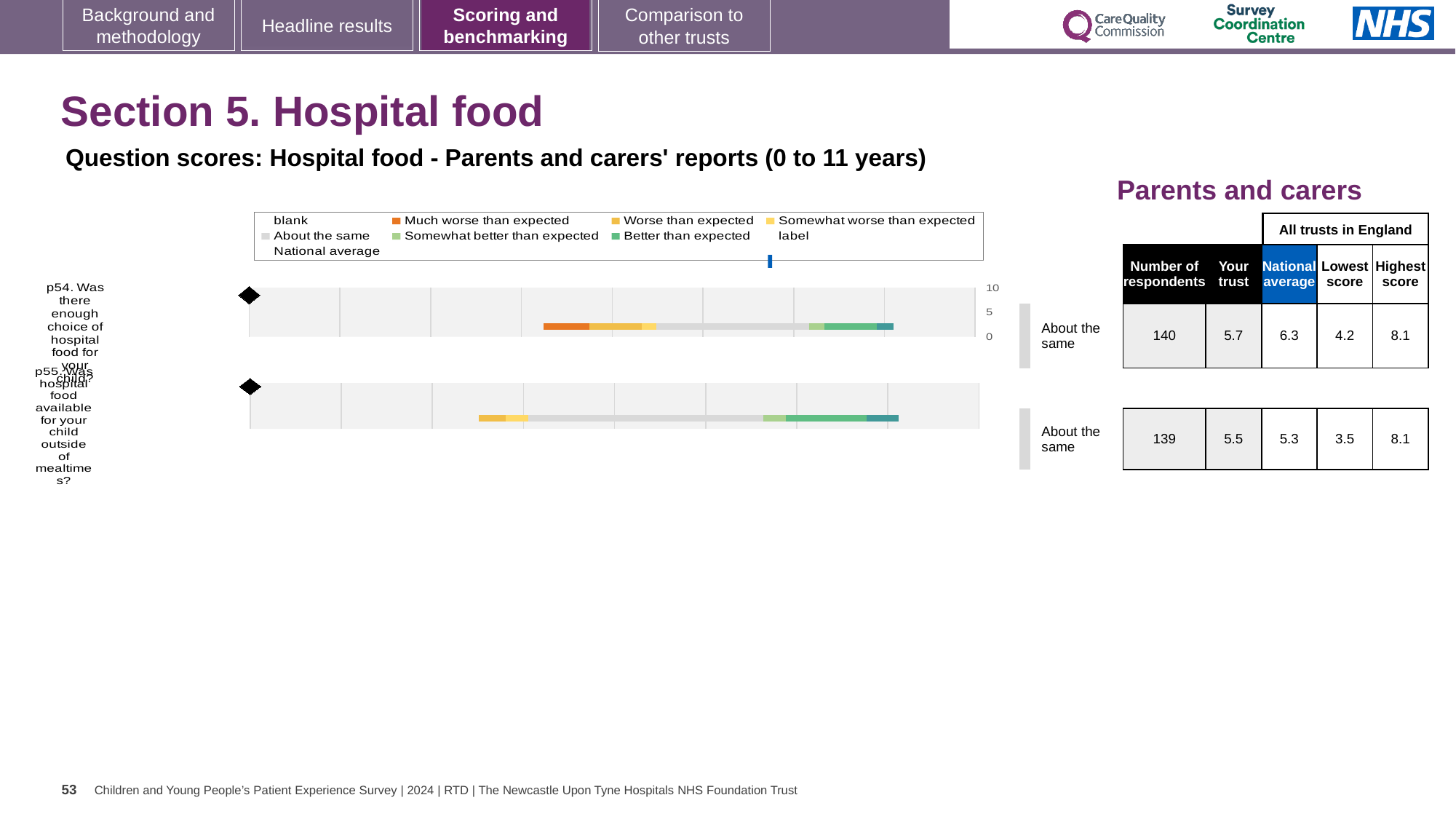
How many respondents answered p54? 140 By how much does the national average exceed the 'Your trust' score for p54? 0.6 What is the lowest score among all trusts in England for p54? 4.2 What benchmark category is shown for p55? About the same Is the 'Your trust' score for p54 greater or less than 5? greater What is the national average score for p55 (food available outside of mealtimes)? 5.3 What is the difference between the highest score and the lowest score for p55? 4.6 How many questions are plotted in the hospital food chart? 2 For p54, which is larger: the 'Your trust' score or the national average? National average What kind of chart is used to show the question scores for hospital food? bar chart Which question has the higher 'Your trust' score, p54 or p55? p54 What is the 'Your trust' score for p54 (enough choice of hospital food)? 5.7